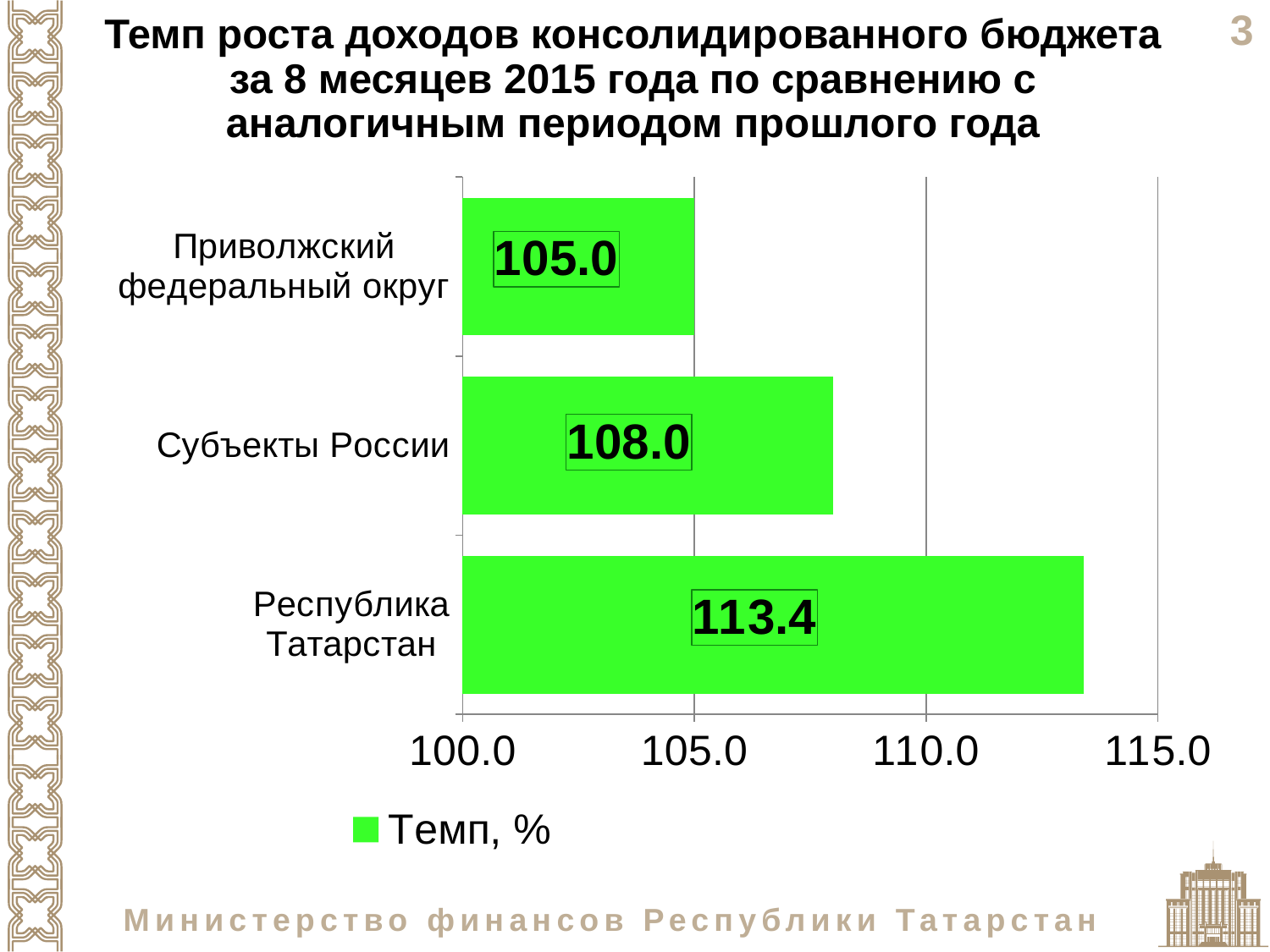
What kind of chart is shown on the slide? bar chart Which category has the highest value? Республика Татарстан How many series does the legend list? 1 What is the value for Республика Татарстан? 113.4 Is the value for Республика Татарстан greater or less than 110.0? greater How many categories are shown in the chart? 3 What is the value for Приволжский федеральный округ? 105.0 Which is larger, the value for Субъекты России or the value for Приволжский федеральный округ? Субъекты России What is the difference between the values for Субъекты России and Приволжский федеральный округ? 3.0 What is the value for Субъекты России? 108.0 Which category has the lowest value? Приволжский федеральный округ What is the difference between the values for Республика Татарстан and Субъекты России? 5.4